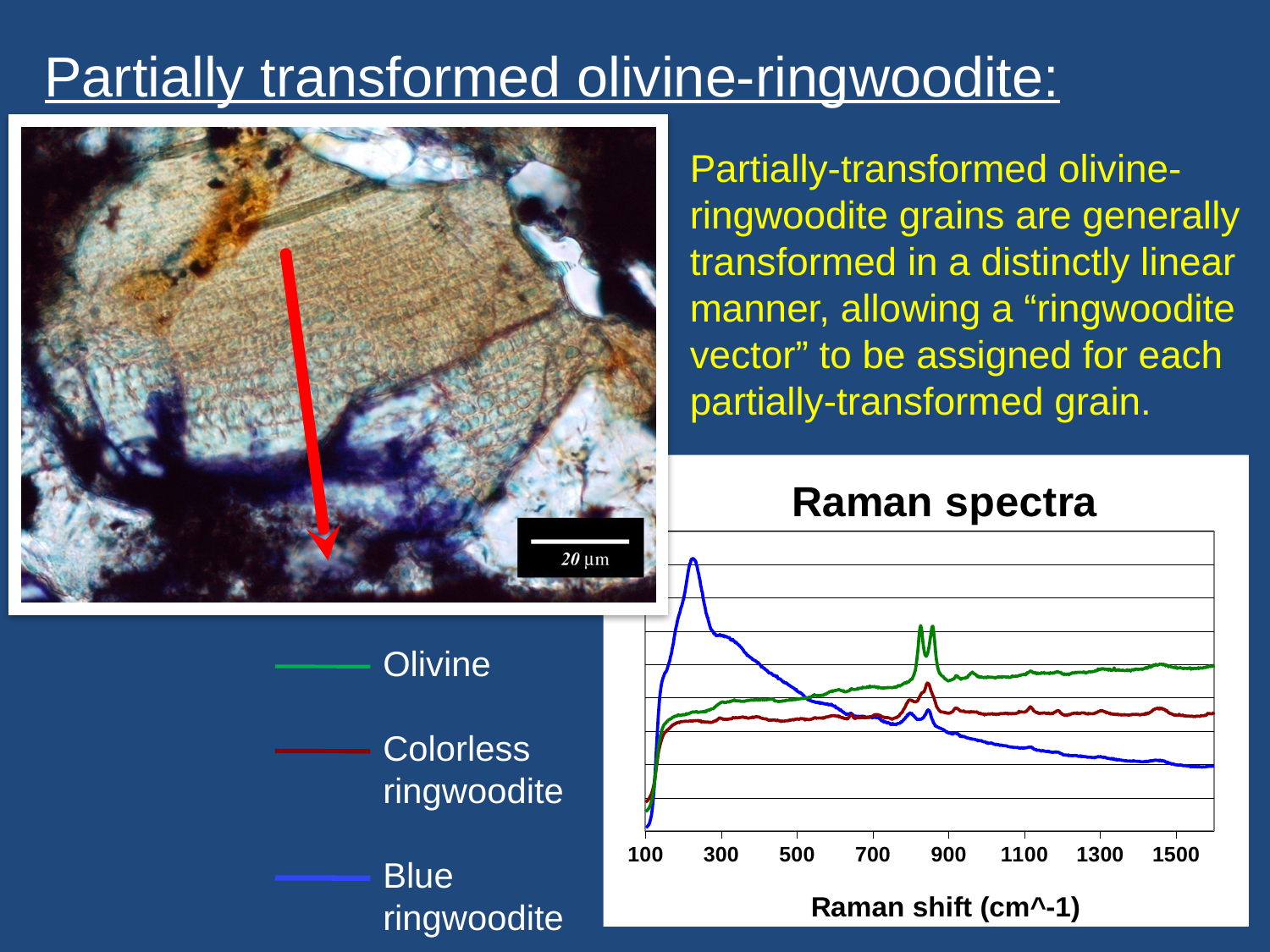
In the Raman spectra chart, which series is lowest at the right end of the x axis (1500)? Blue ringwoodite In the Raman spectra chart, does the Olivine line rise or fall overall between 300 and 1500 on the x axis? rise What is the label of the x axis of the Raman spectra chart? Raman shift (cm^-1) In the Raman spectra chart, at 1500 on the x axis, which is higher: Olivine or Colorless ringwoodite? Olivine In the Raman spectra chart, which series is highest at the right end of the x axis (1500)? Olivine What kind of chart is shown under the title "Raman spectra"? line chart In the Raman spectra chart, does the Blue ringwoodite line rise or fall between 300 and 1500 on the x axis? fall What is the largest tick value shown on the x axis of the Raman spectra chart? 1500 What is the title of the chart on the slide? Raman spectra How many series does the legend of the Raman spectra chart list? 3 How many tick labels are shown on the x axis of the Raman spectra chart? 8 In the Raman spectra chart, which series reaches the highest peak? Blue ringwoodite